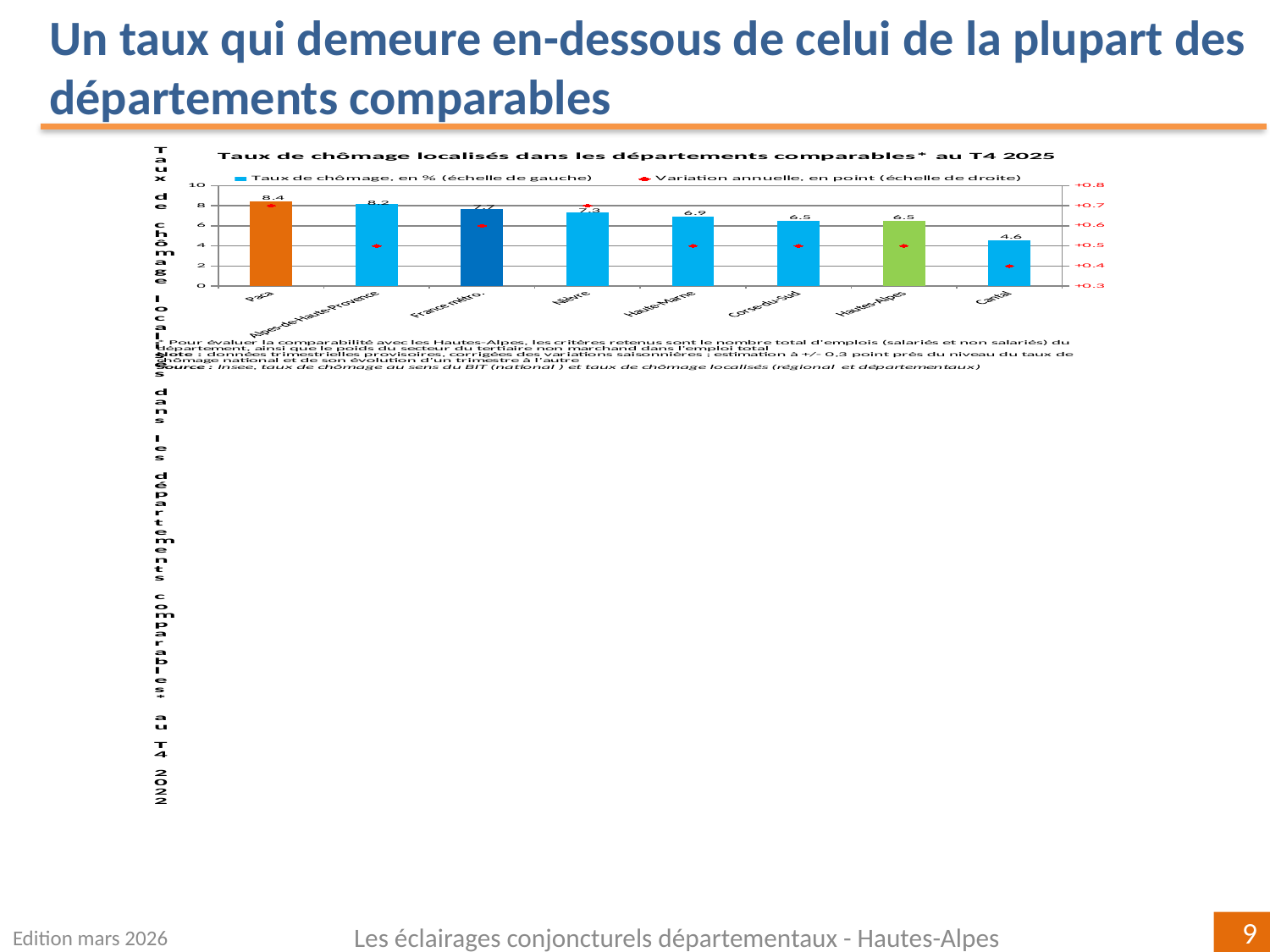
Is the annual variation (variation annuelle) for Paca greater or less than +0.5? greater How many series does the chart legend list? 2 Which department has the highest unemployment rate on the chart? Paca Which department has the lowest unemployment rate on the chart? Cantal What is the unemployment rate (taux de chômage) shown for Paca? 8.4 What is the unemployment rate shown for Hautes-Alpes? 6.5 What is the unemployment rate shown for Cantal? 4.6 What is the title of the chart? Taux de chômage localisés dans les départements comparables* au T4 2025 What is the difference between the unemployment rates of Paca and Hautes-Alpes? 1.9 How many departments or areas are shown on the x axis of the chart? 8 What is the unemployment rate shown for France métro.? 7.7 Which has a higher unemployment rate, Nièvre or Haute-Marne? Nièvre